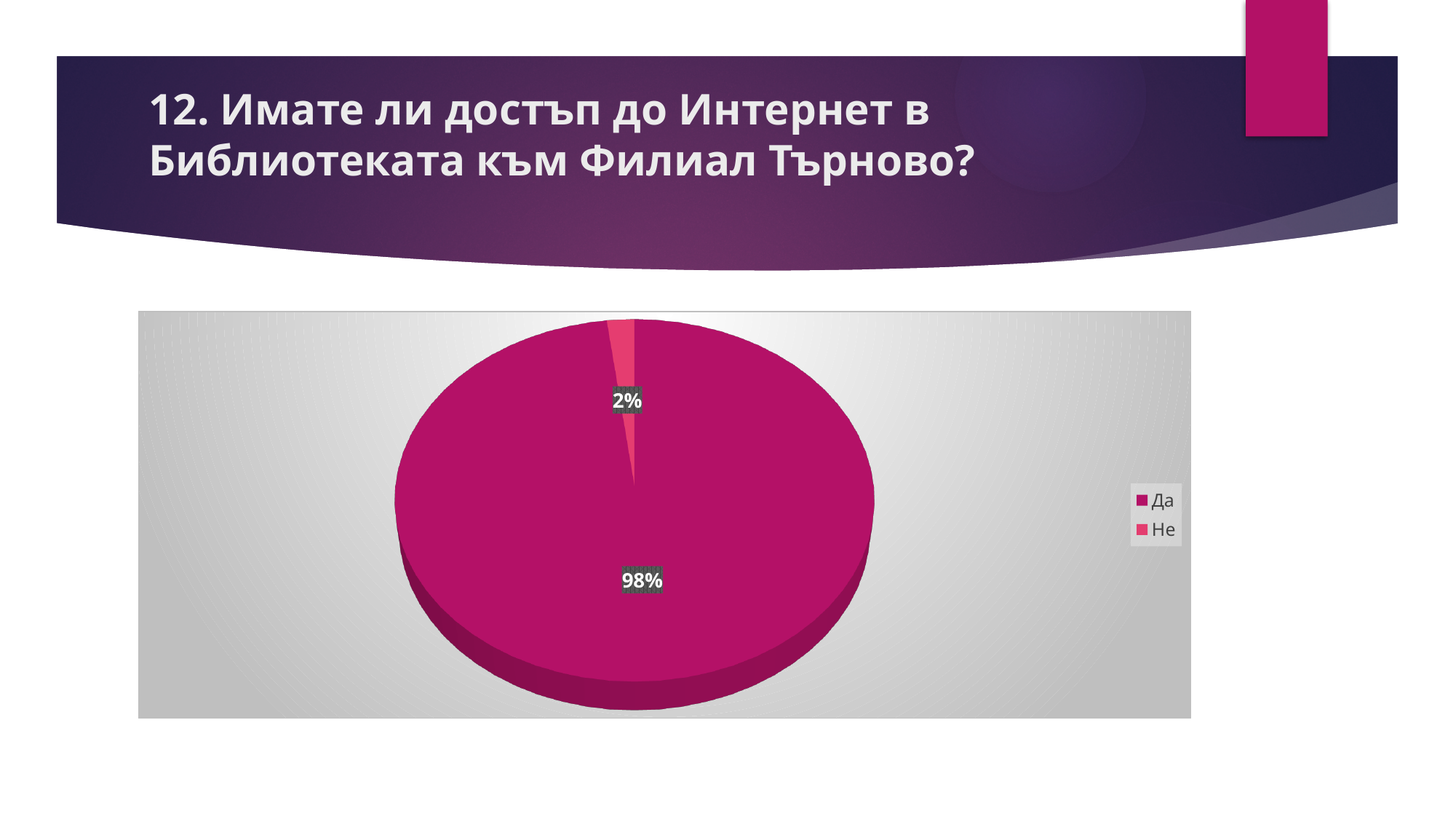
How many entries does the legend list? 2 What percentage of the pie is labelled "Да"? 98% What share of the pie does the "Не" slice represent? 2% What kind of chart is shown on the slide? pie chart How many slices does the pie chart have? 2 Which slice is larger, "Да" or "Не"? Да What percentage of the pie is labelled "Не"? 2% Which category has the smallest slice of the pie? Не Which legend entry is shown in the lighter pink colour? Не Which category has the largest slice of the pie? Да What is the difference in percentage points between the "Да" and "Не" slices? 96 What is the title of the slide containing the chart? 12. Имате ли достъп до Интернет в Библиотеката към Филиал Търново?